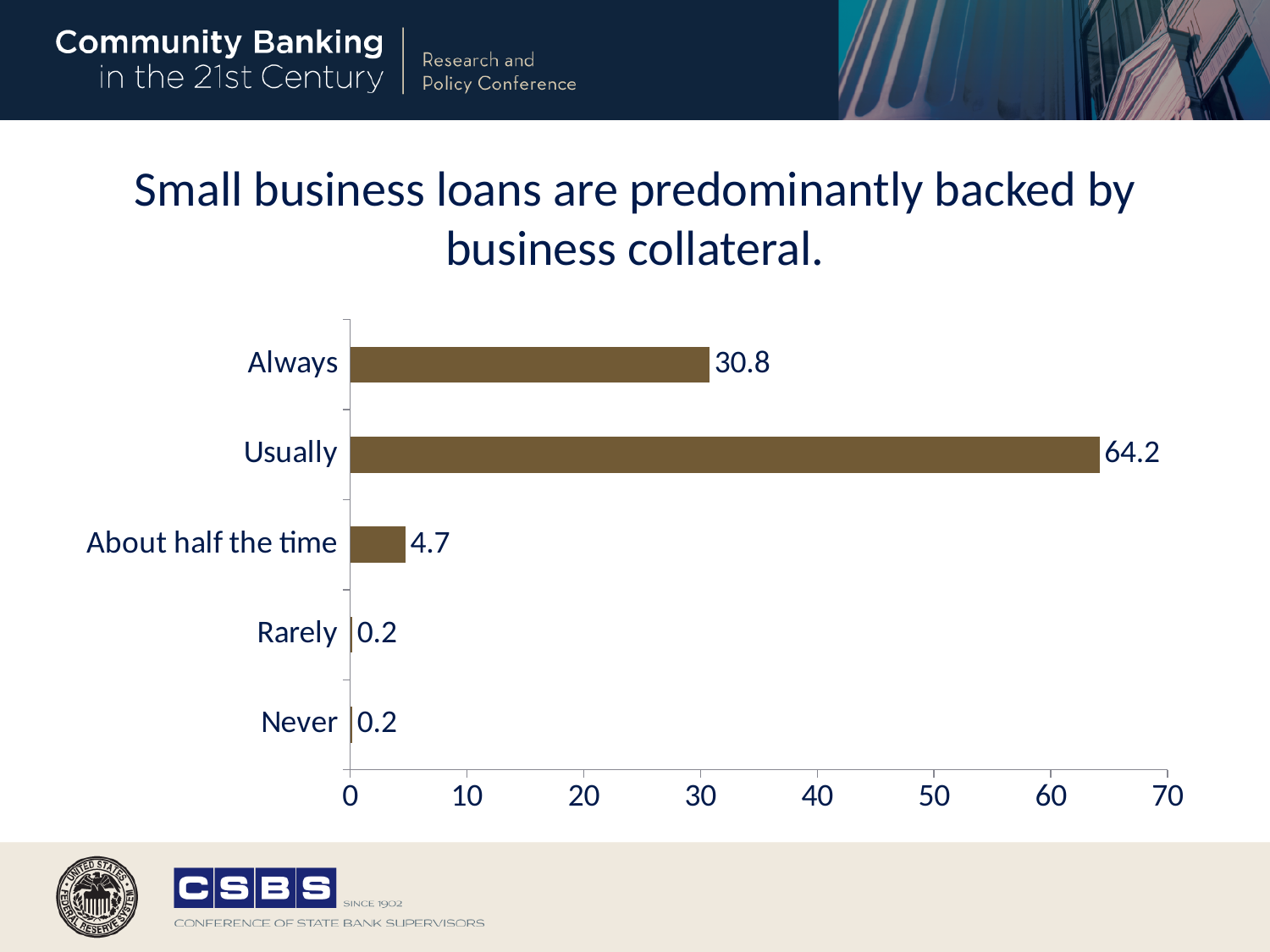
What is the title of the slide? Small business loans are predominantly backed by business collateral. What is the value for About half the time? 4.7 Which category has the highest value? Usually How many categories are shown in the chart? 5 What is the difference between the values for Usually and Always? 33.4 Is the value for Usually greater or less than 60? greater What is the difference between the values for Always and About half the time? 26.1 What is the value for Usually? 64.2 Which is larger, the value for Always or the value for About half the time? Always What is the value for Always? 30.8 What kind of chart is shown on the slide? bar chart What is the value for Rarely? 0.2